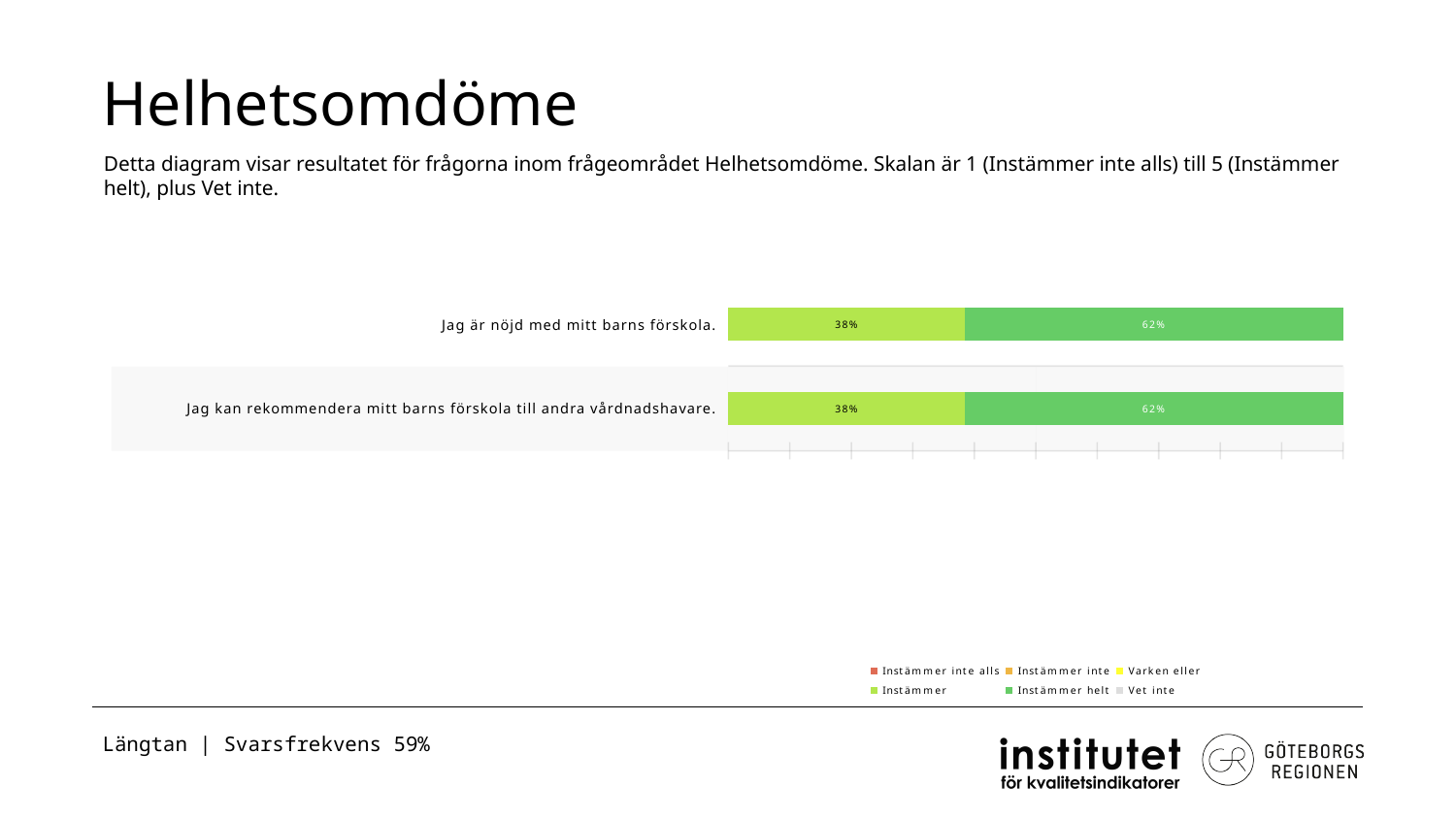
What is the value of the "Instämmer helt" segment for "Jag kan rekommendera mitt barns förskola till andra vårdnadshavare."? 62% What is the value of the "Instämmer" segment for "Jag är nöjd med mitt barns förskola."? 38% What is the response rate (Svarsfrekvens) shown at the bottom of the slide? 59% What kind of chart is shown on the slide? Stacked bar chart How many categories (questions) are plotted in the chart? 2 For "Jag är nöjd med mitt barns förskola.", which segment is larger: "Instämmer" or "Instämmer helt"? Instämmer helt What is the difference between the "Instämmer helt" and "Instämmer" segments for "Jag kan rekommendera mitt barns förskola till andra vårdnadshavare."? 24% Which legend entry is shown in the darker green colour? Instämmer helt What is the value of the "Instämmer" segment for "Jag kan rekommendera mitt barns förskola till andra vårdnadshavare."? 38% What is the total of the two labelled segments in the bar for "Jag är nöjd med mitt barns förskola."? 100% What is the value of the "Instämmer helt" segment for "Jag är nöjd med mitt barns förskola."? 62% How many series does the legend list? 6